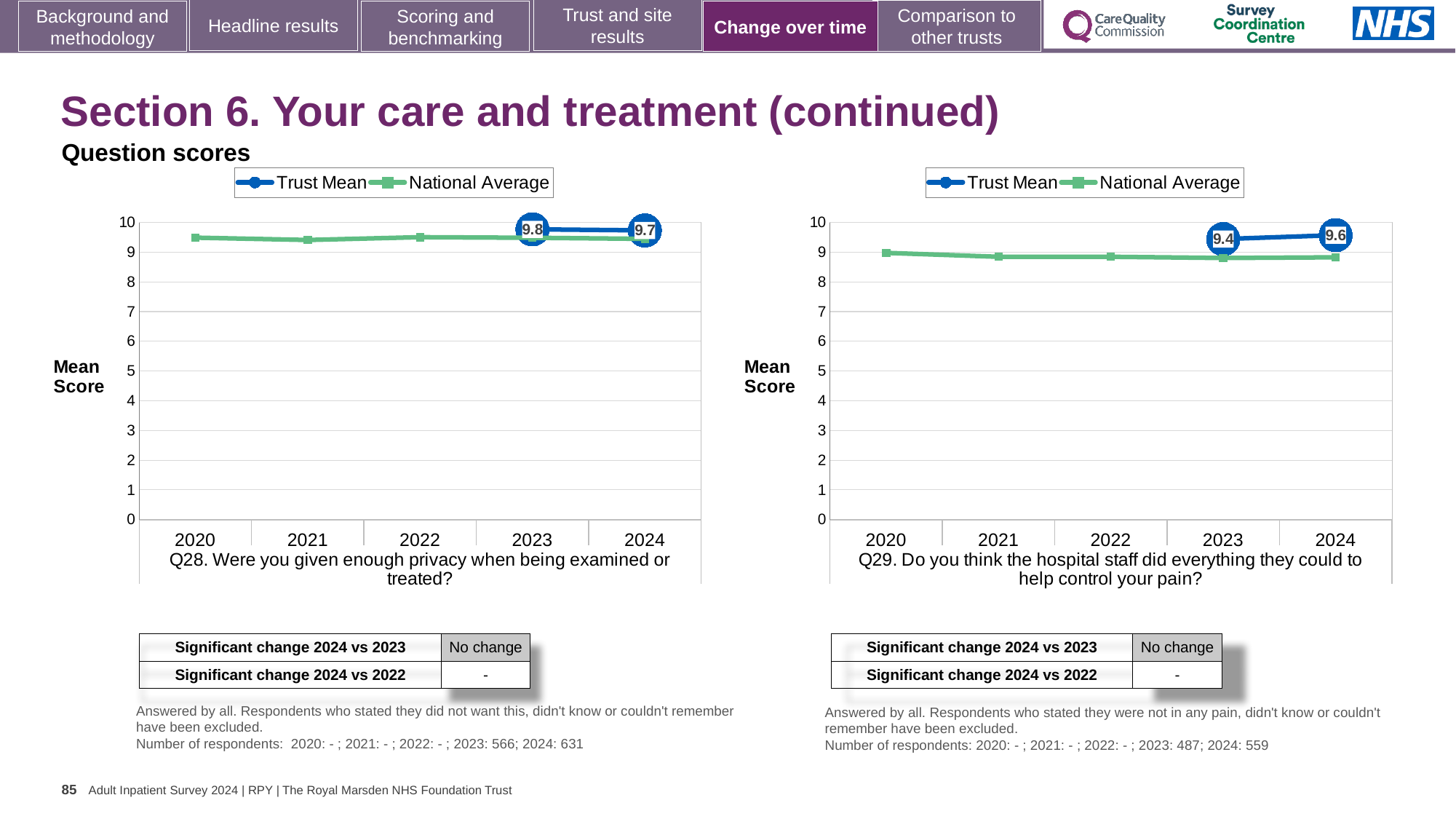
In the Q28 chart (left), is the National Average for 2020 greater or less than 9? greater In the Q29 chart (right), which is larger in 2024, the Trust Mean or the National Average? Trust Mean What kind of chart is the Q29 chart (right)? line chart In the Q29 chart (right), is the National Average for 2024 greater or less than 9? less In the Q28 chart (left), what is the Trust Mean for 2023? 9.8 In the Q29 chart (right), did the Trust Mean rise or fall from 2023 to 2024? rise In the Q29 chart (right), what is the Trust Mean for 2024? 9.6 In the Q29 chart (right), by how much did the Trust Mean change from 2023 to 2024? 0.2 How many series does the legend of the Q28 chart (left) list? 2 In the Q28 chart (left), did the Trust Mean rise or fall from 2023 to 2024? fall In the Q29 chart (right), what is the Trust Mean for 2023? 9.4 In the Q28 chart (left), what is the Trust Mean for 2024? 9.7